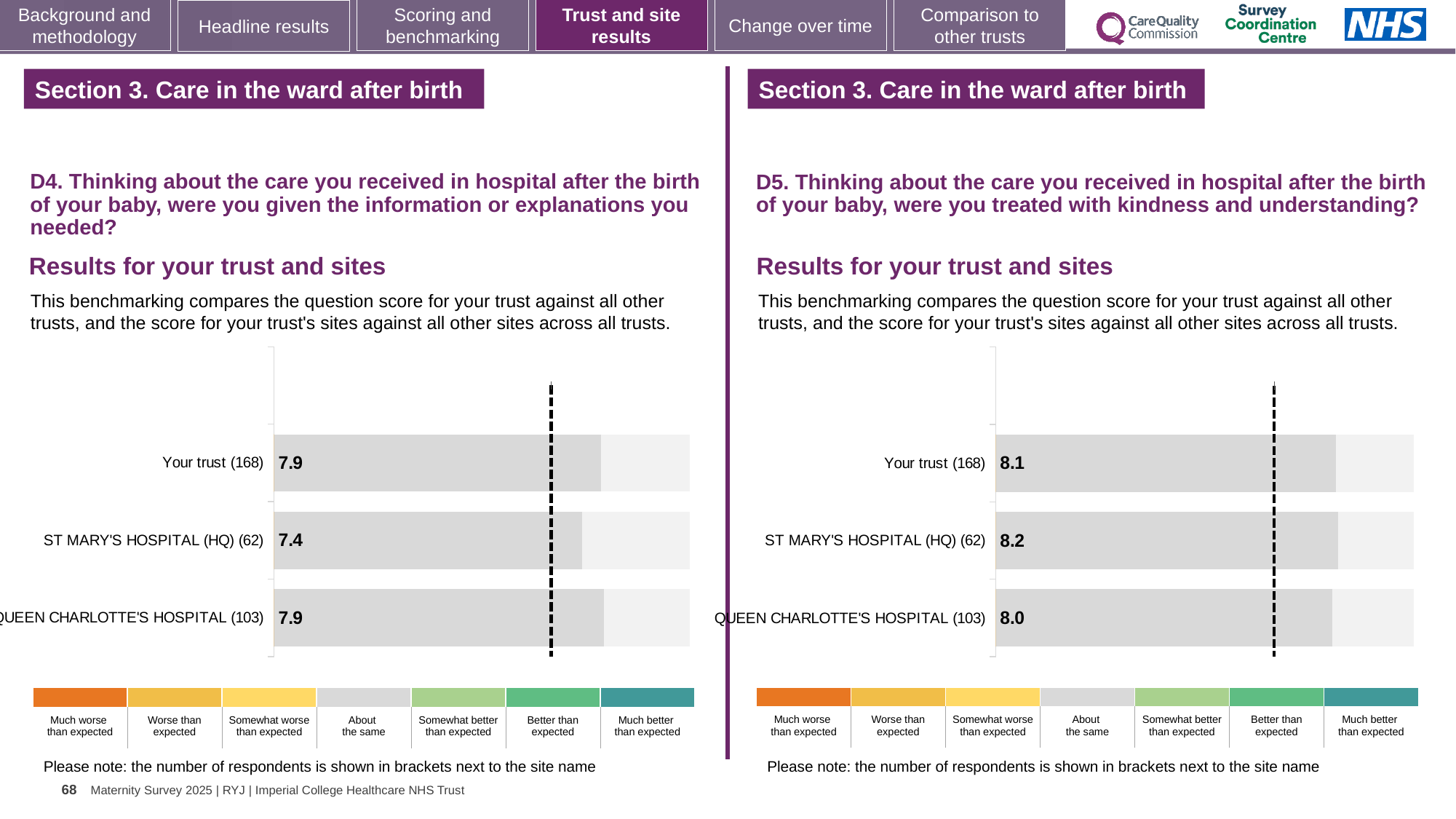
In the D5 chart on the right, what is the difference between the score for ST MARY'S HOSPITAL (HQ) (62) and the score for QUEEN CHARLOTTE'S HOSPITAL (103)? 0.2 In the D5 chart on the right, what is the score for QUEEN CHARLOTTE'S HOSPITAL (103)? 8.0 In the D5 chart on the right, which site or trust has the highest score? ST MARY'S HOSPITAL (HQ) (62) In the D4 chart on the left, which has the larger score: ST MARY'S HOSPITAL (HQ) (62) or QUEEN CHARLOTTE'S HOSPITAL (103)? QUEEN CHARLOTTE'S HOSPITAL (103) In the D4 chart on the left, what is the score for ST MARY'S HOSPITAL (HQ) (62)? 7.4 How many bars are shown in the D5 chart on the right? 3 In the D4 chart on the left, how many respondents are shown in brackets for QUEEN CHARLOTTE'S HOSPITAL? 103 In the D5 chart on the right, what is the score for Your trust (168)? 8.1 In the D4 chart on the left, which site or trust has the lowest score? ST MARY'S HOSPITAL (HQ) (62) In the D4 chart on the left, what is the score for Your trust (168)? 7.9 In the D4 chart on the left, what is the difference between the score for Your trust (168) and the score for ST MARY'S HOSPITAL (HQ) (62)? 0.5 What type of chart is used in the D4 chart on the left? Bar chart